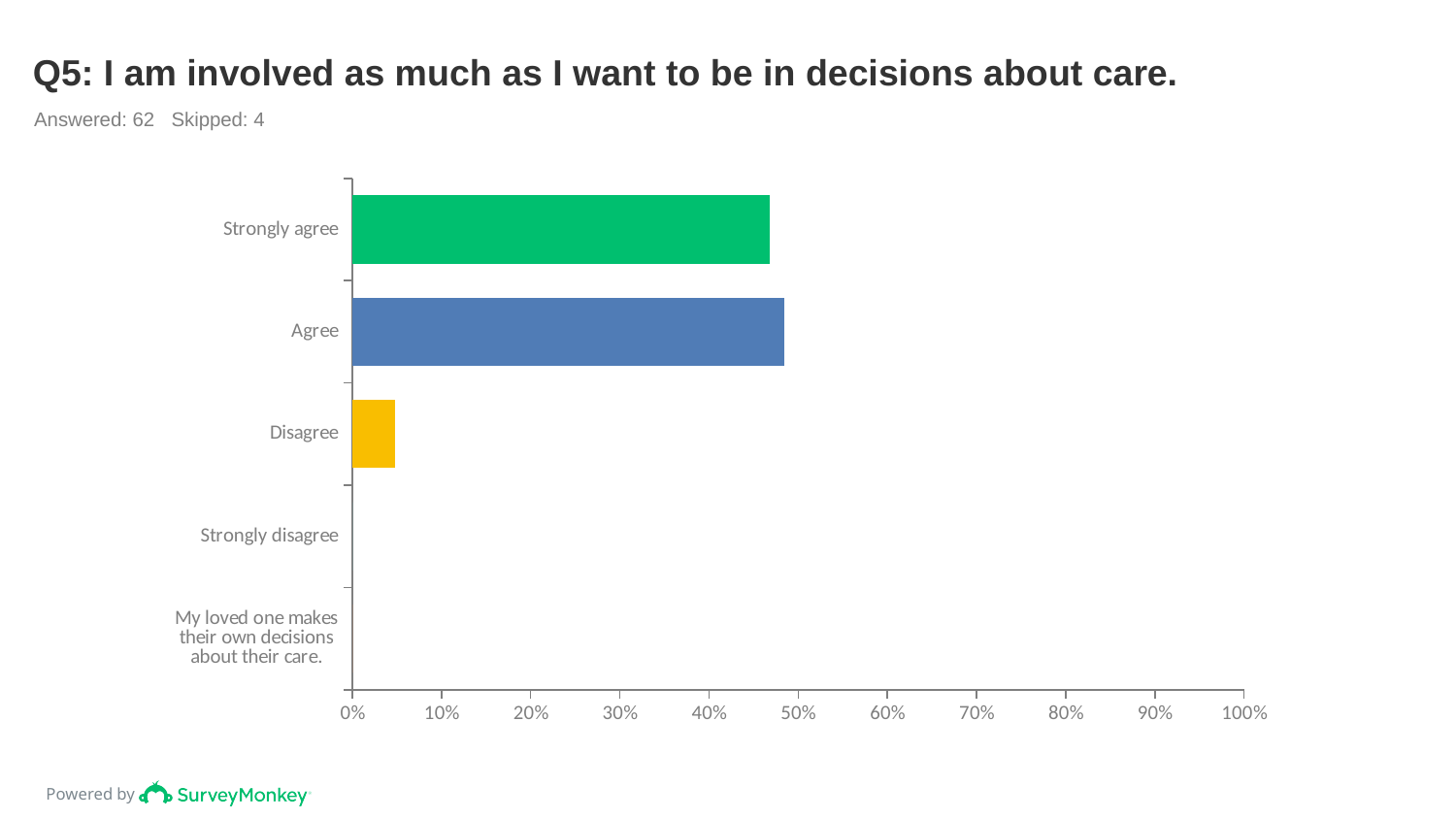
Is the value for Agree greater or less than 40%? greater Is the value for Strongly agree greater or less than 50%? less How many response categories are listed on the chart? 5 Which has the larger value, Agree or Disagree? Agree Is the value for Disagree greater or less than 10%? less What is the title of the chart? Q5: I am involved as much as I want to be in decisions about care. What kind of chart is shown on the slide? bar chart How many respondents answered this question according to the slide? 62 Which has the larger value, Strongly agree or Disagree? Strongly agree